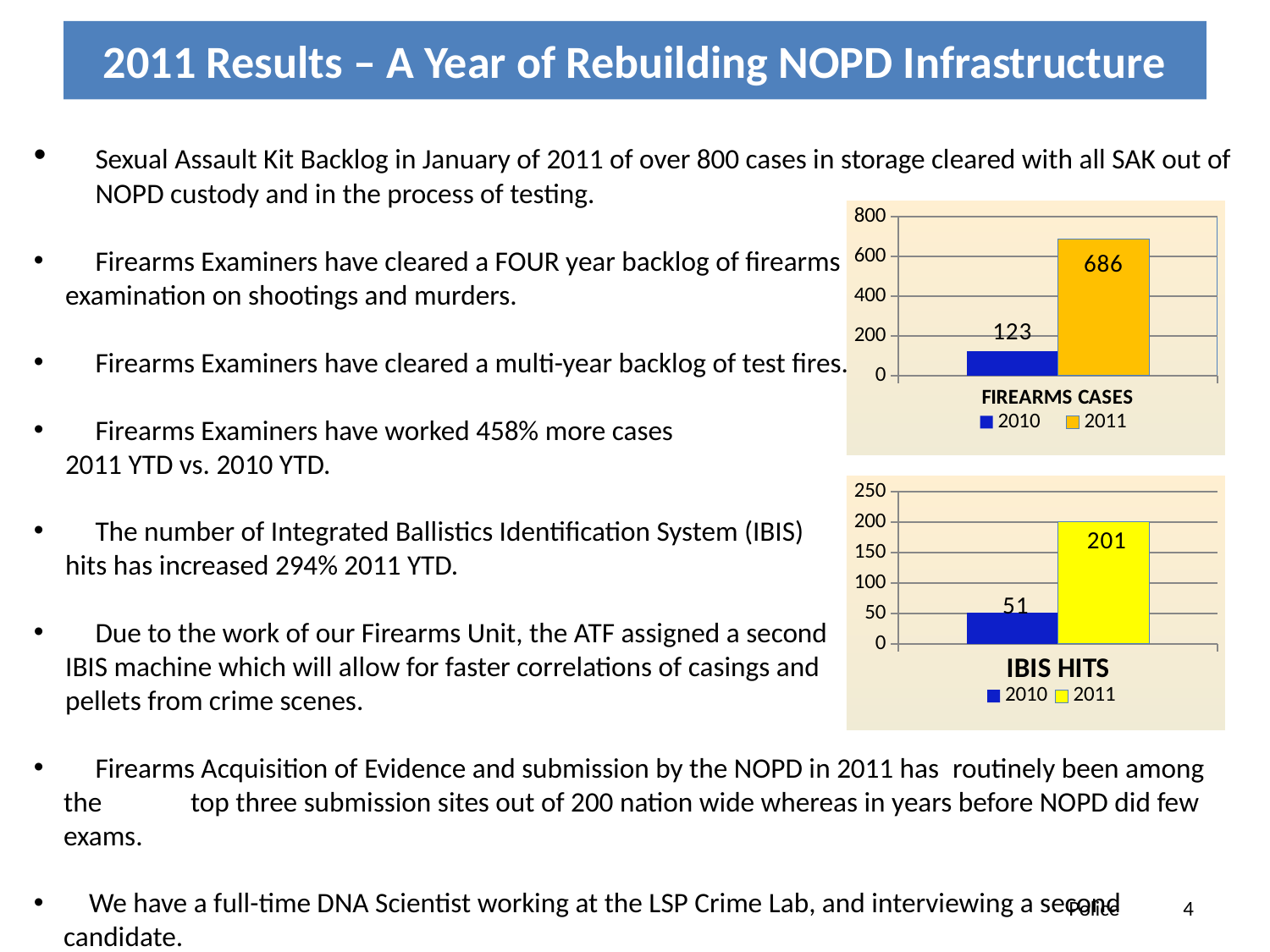
In the IBIS HITS chart, what is the value for 2010? 51 What kind of chart is the IBIS HITS chart? bar chart In the FIREARMS CASES chart, is the value for 2011 greater or less than 600? greater In the FIREARMS CASES chart, which year has the higher value, 2010 or 2011? 2011 In the IBIS HITS chart, what is the difference between the 2011 and 2010 values? 150 In the FIREARMS CASES chart, what is the difference between the 2011 and 2010 values? 563 In the FIREARMS CASES chart, what is the value for 2010? 123 In the FIREARMS CASES chart, what is the value for 2011? 686 How many series does the legend of the IBIS HITS chart list? 2 In the IBIS HITS chart, what is the value for 2011? 201 In the IBIS HITS chart, which series has the lowest value? 2010 In the FIREARMS CASES chart, what colour is the bar for 2011? orange